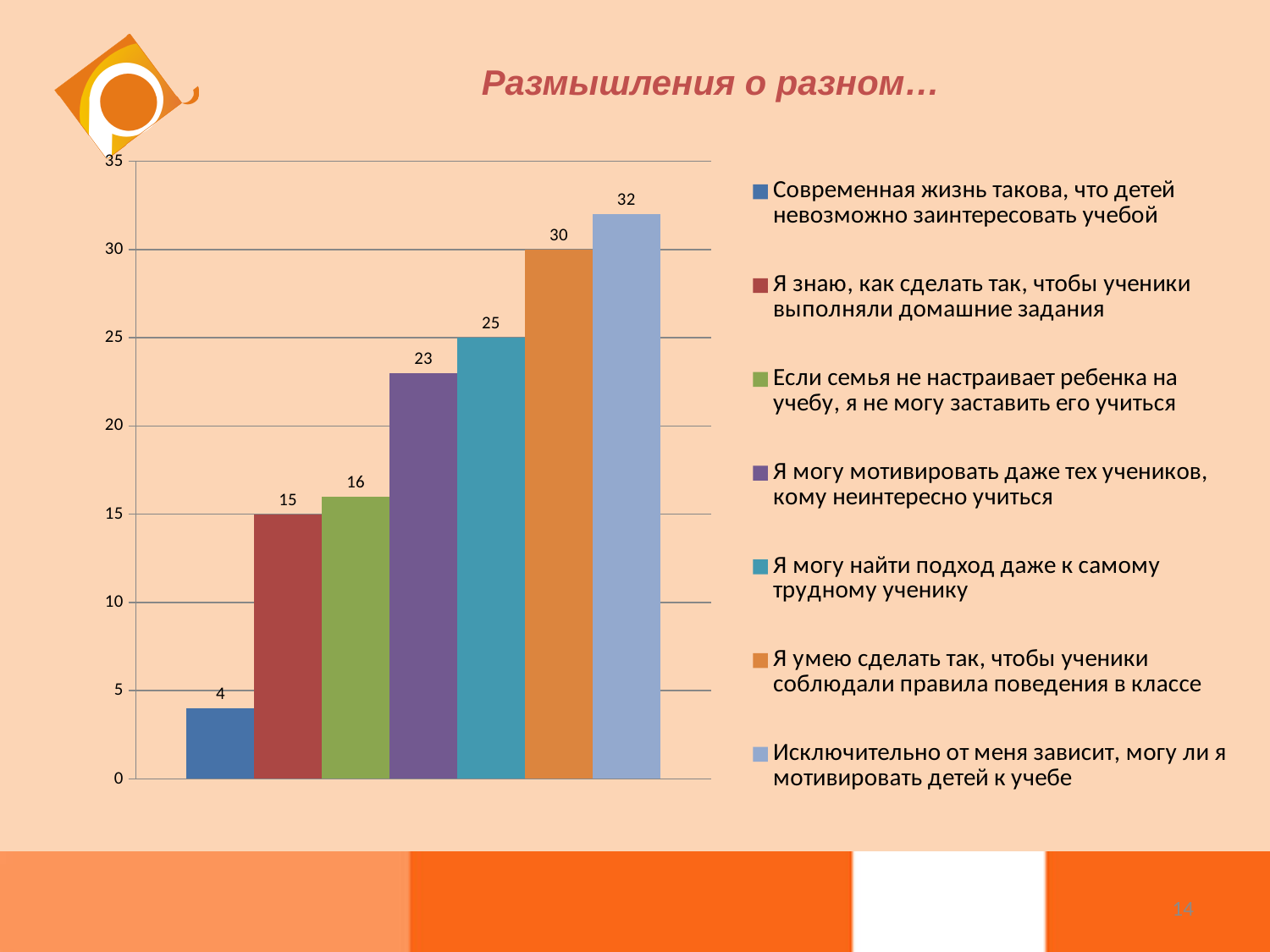
What is the title of the slide? Размышления о разном… How many series does the legend list? 7 Which is larger: the value for "Я знаю, как сделать так, чтобы ученики выполняли домашние задания" or for "Если семья не настраивает ребенка на учебу, я не могу заставить его учиться"? Если семья не настраивает ребенка на учебу, я не могу заставить его учиться What is the difference between the values for "Исключительно от меня зависит, могу ли я мотивировать детей к учебе" and "Я могу мотивировать даже тех учеников, кому неинтересно учиться"? 9 What is the value for "Я умею сделать так, чтобы ученики соблюдали правила поведения в классе"? 30 What is the value for "Я могу найти подход даже к самому трудному ученику"? 25 How many bars are plotted on the chart? 7 Which series has the lowest value? Современная жизнь такова, что детей невозможно заинтересовать учебой Which series has the highest value? Исключительно от меня зависит, могу ли я мотивировать детей к учебе What kind of chart is shown on the slide? bar chart What is the value for "Современная жизнь такова, что детей невозможно заинтересовать учебой"? 4 Is the value for "Я могу мотивировать даже тех учеников, кому неинтересно учиться" greater or less than 20? greater